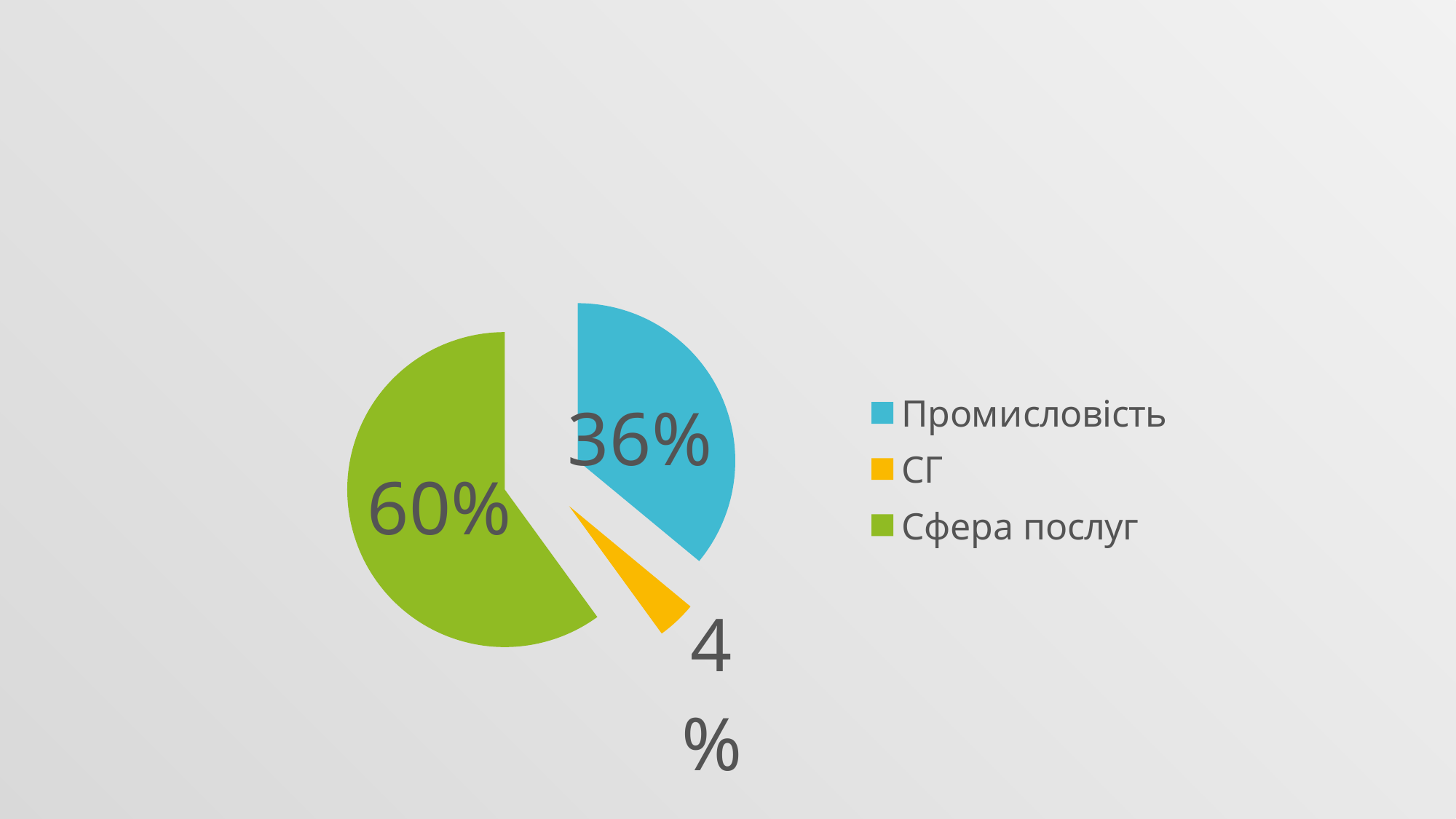
Which category has the smallest slice of the pie? СГ What share of the pie does СГ have? 4% What share of the pie does Сфера послуг have? 60% What is the difference in percentage points between Промисловість and СГ? 32 What is the difference in percentage points between Сфера послуг and Промисловість? 24 Which category has the largest slice of the pie? Сфера послуг Which is larger, the share for Промисловість or the share for Сфера послуг? Сфера послуг What kind of chart is shown on the slide? pie chart What colour is the slice for СГ? yellow What share of the pie does Промисловість have? 36% Which category is shown in blue in the legend? Промисловість How many categories are shown in the pie chart? 3